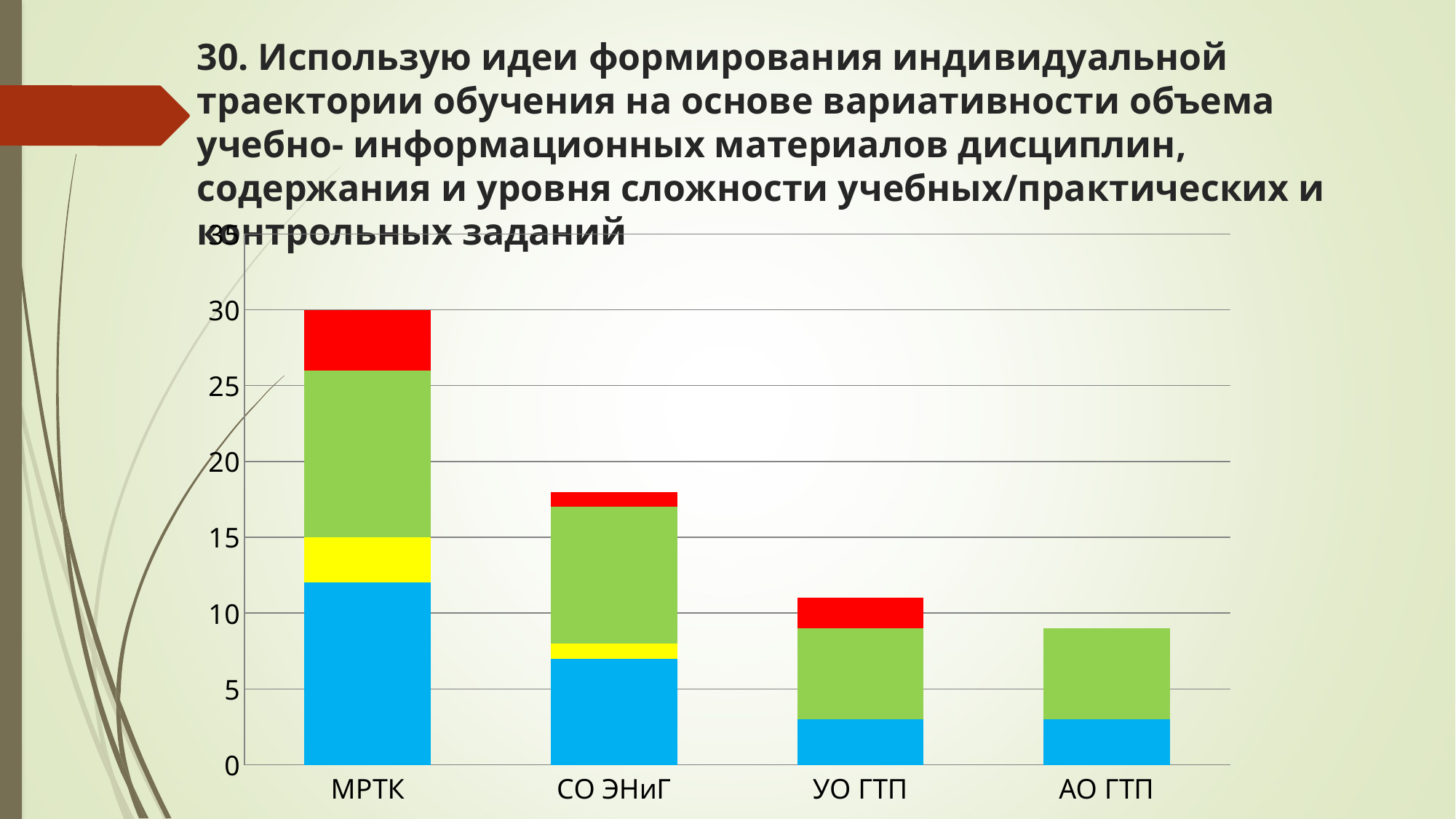
Is the total for УО ГТП greater or less than 10? greater Which category has the shortest stacked bar? АО ГТП Is the blue segment for МРТК greater or less than 10? greater Which stacked bar is taller, СО ЭНиГ or УО ГТП? СО ЭНиГ What is the total height of the stacked bar for МРТК? 30 What kind of chart is shown on the slide? bar chart How many coloured segments make up the МРТК bar? 4 Which category has the tallest stacked bar? МРТК How many categories are shown on the x axis of the chart? 4 Is the total for АО ГТП greater or less than 10? less What is the highest value shown on the y axis? 35